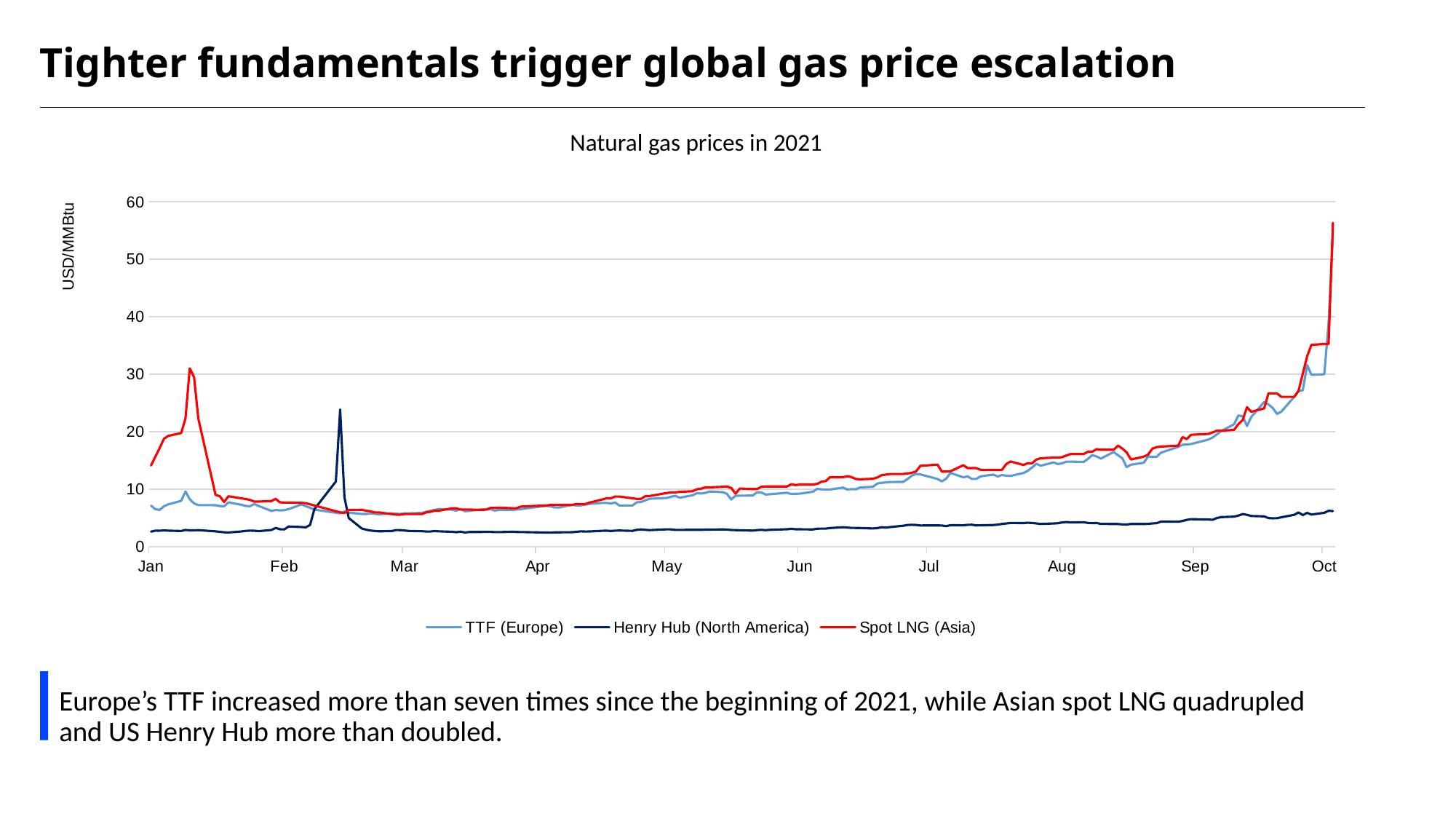
What kind of chart is shown on the slide? line chart How many month labels are shown on the x axis? 10 Which series stays lowest for most of the year? Henry Hub (North America) Is the value for Henry Hub (North America) in Jun greater or less than 10? less How many series does the legend list? 3 At the start of Oct, which is higher: TTF (Europe) or Henry Hub (North America)? TTF (Europe) Is the value for TTF (Europe) at the start of Jan greater or less than 10? less Which series reaches the highest value on the chart? Spot LNG (Asia) What unit is shown on the vertical axis of the chart? USD/MMBtu Does the TTF (Europe) price rise or fall from Jan to Oct? rise What is the title of the chart? Natural gas prices in 2021